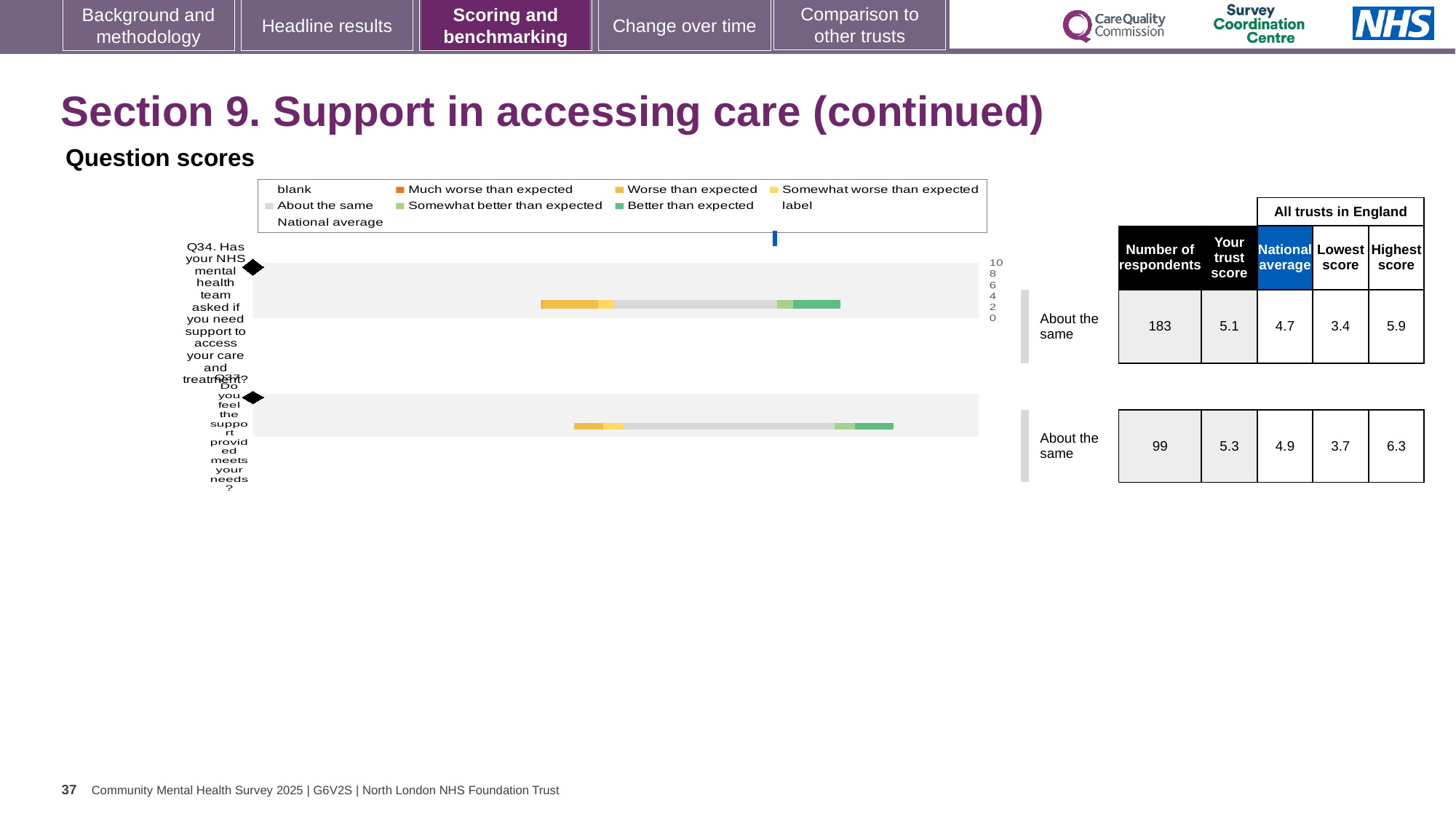
How many respondents answered Q37? 99 What is the trust score for Q37 (Do you feel the support provided meets your needs)? 5.3 What kind of chart is used to show the question scores for Q34 and Q37? Bar chart What is the trust score for Q34 (Has your NHS mental health team asked if you need support to access your care and treatment)? 5.1 Which question has the higher trust score, Q34 or Q37? Q37 What is the maximum value shown on the score axis of the chart? 10 What is the national average score for Q34? 4.7 What is the lowest score among all trusts in England for Q34? 3.4 How many questions are plotted in the question scores chart? 2 What is the highest score among all trusts in England for Q37? 6.3 What benchmark category is shown for Q34? About the same By how much does the trust score for Q34 exceed the national average for Q34? 0.4